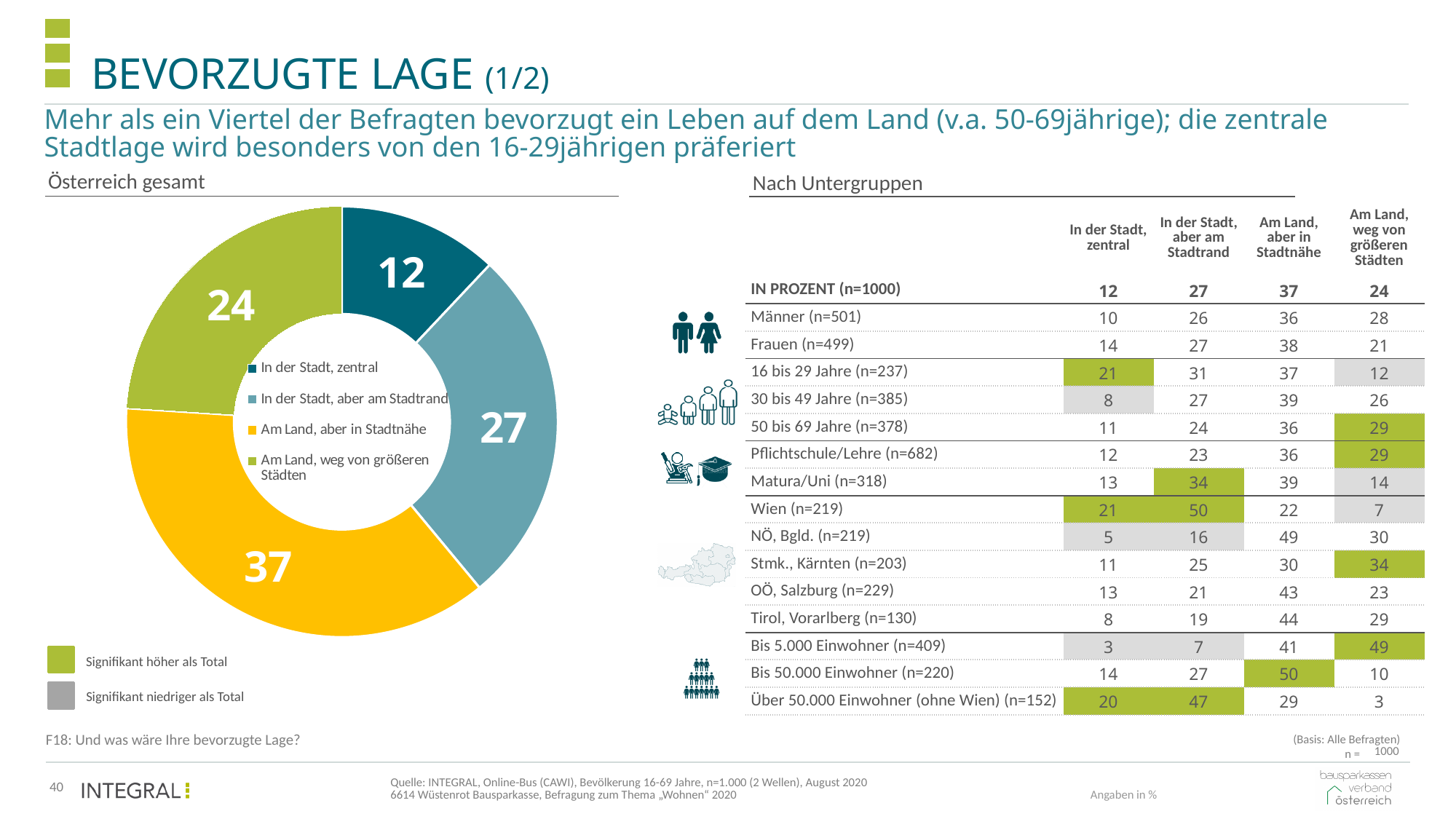
In the 'Österreich gesamt' chart, what is the value for 'In der Stadt, aber am Stadtrand'? 27 In the 'Österreich gesamt' chart, what is the difference between 'Am Land, aber in Stadtnähe' and 'In der Stadt, zentral'? 25 In the 'Österreich gesamt' chart, which category has the smallest slice? In der Stadt, zentral In the 'Österreich gesamt' chart, what is the value for 'In der Stadt, zentral'? 12 In the 'Österreich gesamt' chart, which category is shown in yellow? Am Land, aber in Stadtnähe In the 'Österreich gesamt' chart, what is the value for 'Am Land, aber in Stadtnähe'? 37 In the 'Österreich gesamt' chart, which is larger: 'In der Stadt, aber am Stadtrand' or 'Am Land, weg von größeren Städten'? In der Stadt, aber am Stadtrand How many categories does the 'Österreich gesamt' chart show? 4 In the 'Österreich gesamt' chart, which category has the largest slice? Am Land, aber in Stadtnähe What kind of chart is the 'Österreich gesamt' chart? donut chart In the 'Österreich gesamt' chart, what is the value for 'Am Land, weg von größeren Städten'? 24 In the 'Österreich gesamt' chart, what share of the whole does 'Am Land, weg von größeren Städten' represent? 24%